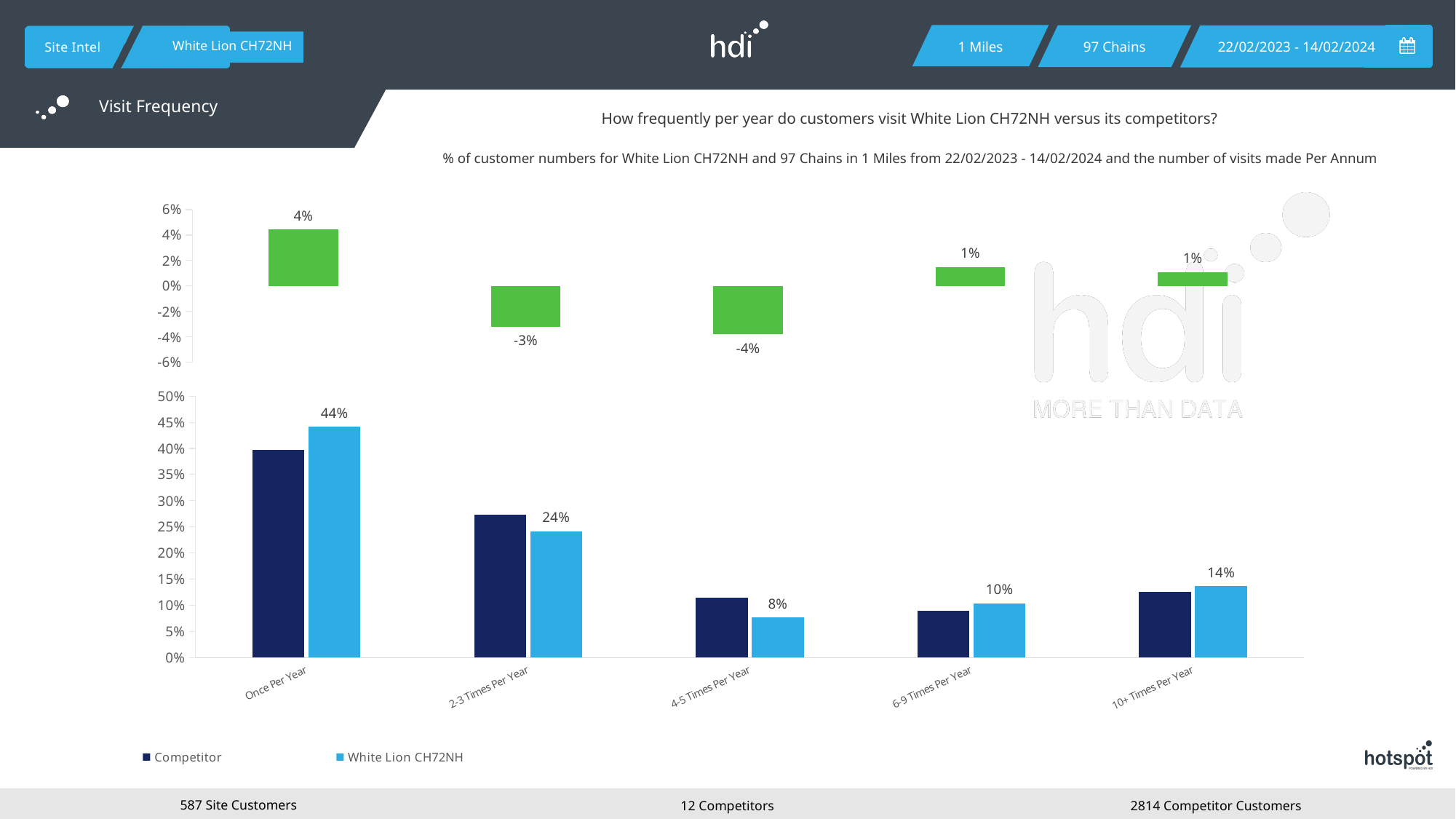
In the bottom chart, how many series does the legend list? 2 In the bottom chart, how many categories are shown on the x axis? 5 In the top chart, what is the value of the leftmost green bar? 4% In the bottom chart, what is the value for White Lion CH72NH for 10+ Times Per Year? 14% In the bottom chart, which category has the highest White Lion CH72NH value? Once Per Year In the bottom chart, which category has the lowest White Lion CH72NH value? 4-5 Times Per Year In the bottom chart, what is the value for White Lion CH72NH for 2-3 Times Per Year? 24% In the top chart, what is the value of the third green bar from the left? -4% In the bottom chart, is the Competitor value for Once Per Year greater or less than 35%? greater In the bottom chart, for 2-3 Times Per Year, which series has the larger value, Competitor or White Lion CH72NH? Competitor In the bottom chart, what is the value for White Lion CH72NH for Once Per Year? 44% In the bottom chart, what is the difference between the White Lion CH72NH values for Once Per Year and 2-3 Times Per Year? 20%